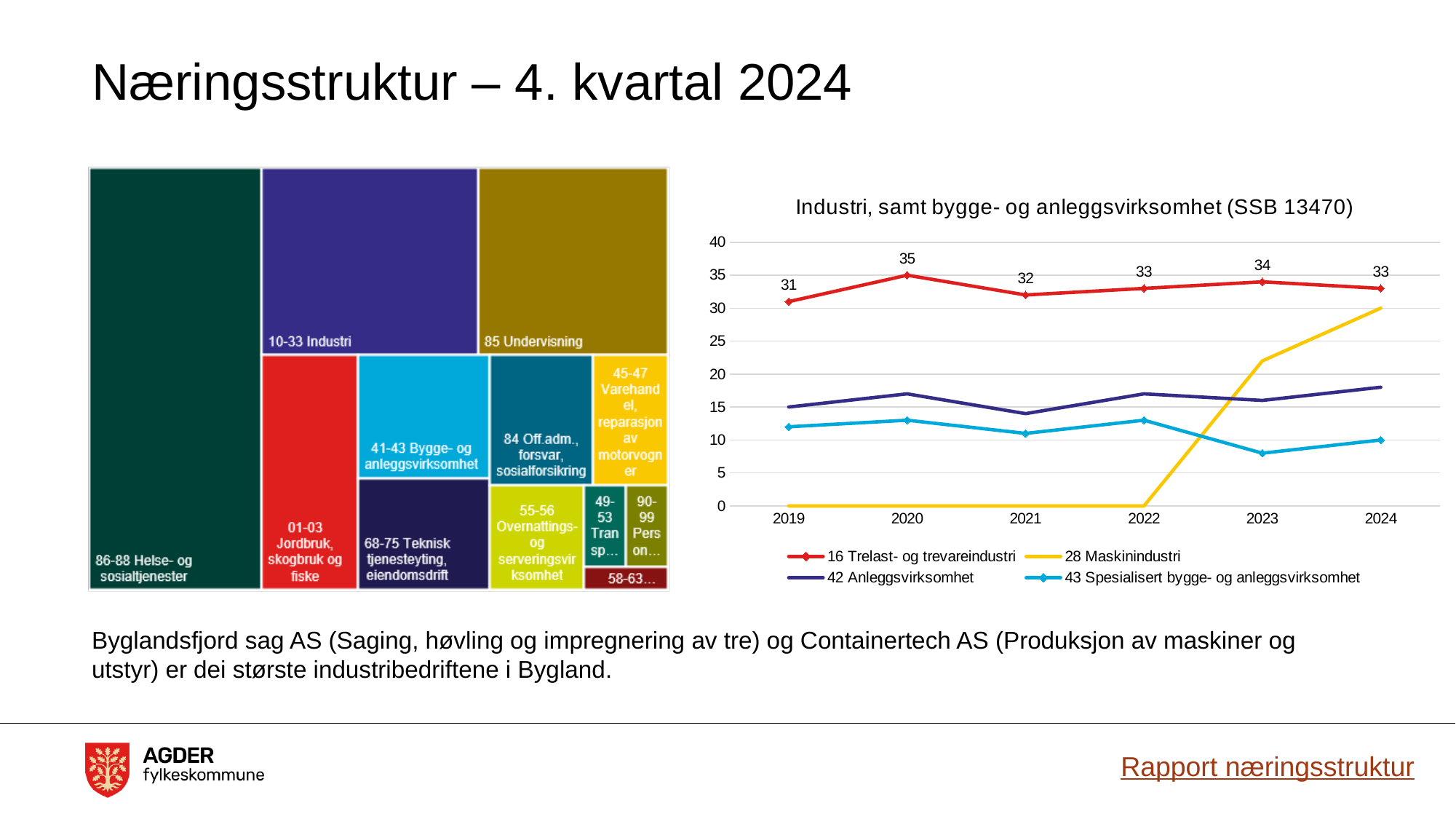
In the line chart 'Industri, samt bygge- og anleggsvirksomhet (SSB 13470)', what is the value for 16 Trelast- og trevareindustri in 2020? 35 In the line chart 'Industri, samt bygge- og anleggsvirksomhet (SSB 13470)', what is the value for 16 Trelast- og trevareindustri in 2019? 31 In the line chart 'Industri, samt bygge- og anleggsvirksomhet (SSB 13470)', what is the difference between the 2020 and 2019 values for 16 Trelast- og trevareindustri? 4 In the line chart 'Industri, samt bygge- og anleggsvirksomhet (SSB 13470)', what is the value for 16 Trelast- og trevareindustri in 2024? 33 In the line chart 'Industri, samt bygge- og anleggsvirksomhet (SSB 13470)', is the value for 43 Spesialisert bygge- og anleggsvirksomhet in 2023 greater or less than 10? less In the line chart 'Industri, samt bygge- og anleggsvirksomhet (SSB 13470)', which series has the higher value in 2024: 42 Anleggsvirksomhet or 43 Spesialisert bygge- og anleggsvirksomhet? 42 Anleggsvirksomhet In the line chart 'Industri, samt bygge- og anleggsvirksomhet (SSB 13470)', in which year is 16 Trelast- og trevareindustri lowest? 2019 What kind of chart is the chart on the right side of the slide? Line chart In the line chart 'Industri, samt bygge- og anleggsvirksomhet (SSB 13470)', in which year is 16 Trelast- og trevareindustri highest? 2020 In the line chart 'Industri, samt bygge- og anleggsvirksomhet (SSB 13470)', is the value for 28 Maskinindustri in 2023 greater or less than 20? greater How many years are shown on the x axis of the line chart 'Industri, samt bygge- og anleggsvirksomhet (SSB 13470)'? 6 How many series does the legend of the line chart 'Industri, samt bygge- og anleggsvirksomhet (SSB 13470)' list? 4